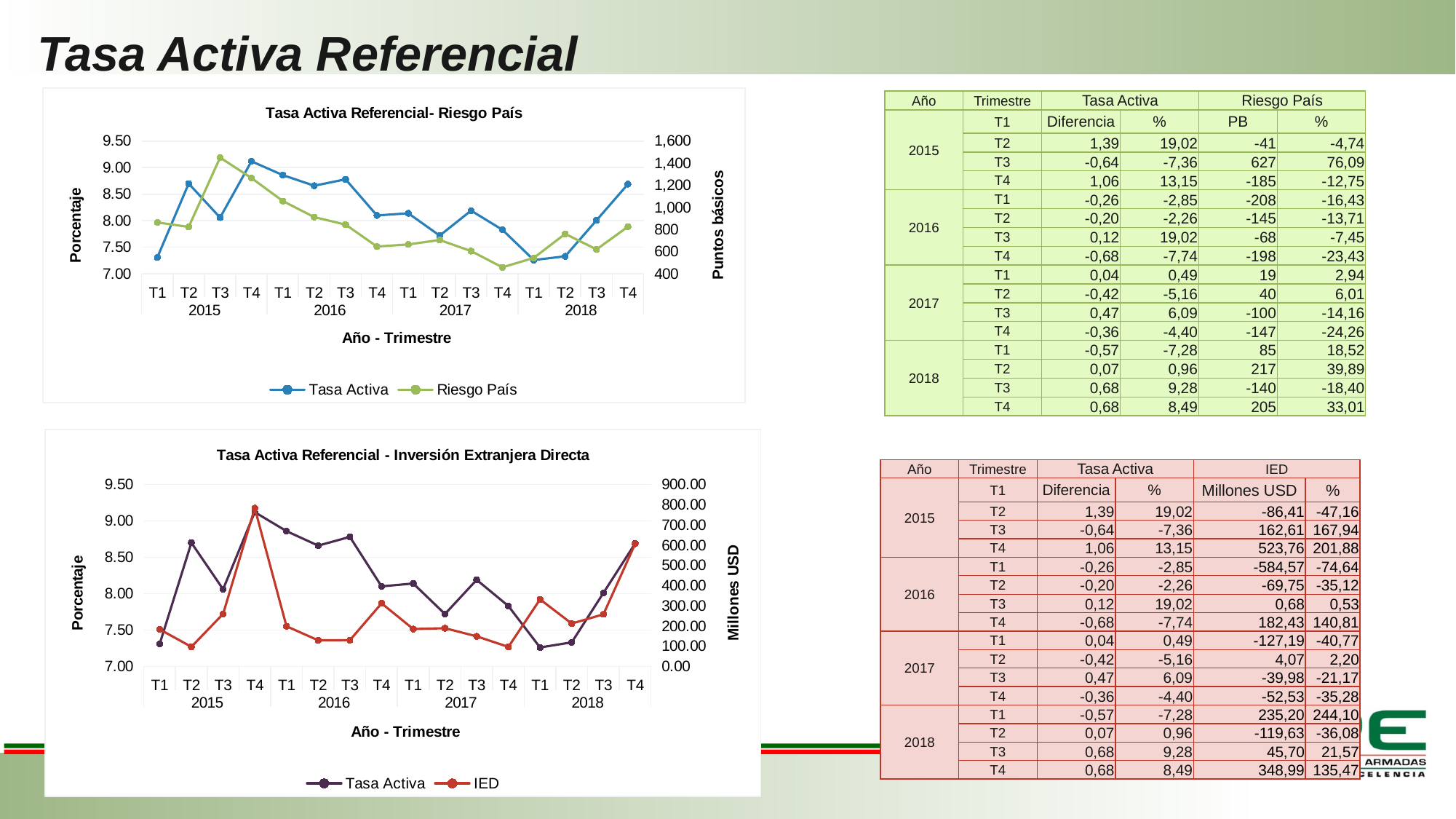
What type of chart is 'Tasa Activa Referencial- Riesgo País'? line chart In the 'Tasa Activa Referencial - Inversión Extranjera Directa' chart, is the IED value for T4 2015 greater or less than 700.00? greater In the 'Tasa Activa Referencial- Riesgo País' chart, in which quarter does Riesgo País reach its lowest value? T4 2017 How many quarterly points are plotted for each series in the 'Tasa Activa Referencial- Riesgo País' chart? 16 In the 'Tasa Activa Referencial- Riesgo País' chart, is the Riesgo País value for T3 2015 greater or less than 1,200? greater In the 'Tasa Activa Referencial - Inversión Extranjera Directa' chart, which is larger, the IED value for T4 2015 or for T1 2016? T4 2015 In the 'Tasa Activa Referencial - Inversión Extranjera Directa' chart, in which quarter does IED reach its highest value? T4 2015 In the 'Tasa Activa Referencial- Riesgo País' chart, in which quarter does Tasa Activa reach its highest value? T4 2015 How many series does the legend of the 'Tasa Activa Referencial - Inversión Extranjera Directa' chart list? 2 In the 'Tasa Activa Referencial- Riesgo País' chart, is the Tasa Activa value for T1 2015 greater or less than 7.50? less In the 'Tasa Activa Referencial - Inversión Extranjera Directa' chart, does Tasa Activa rise or fall from T1 2018 to T4 2018? rise In the 'Tasa Activa Referencial- Riesgo País' chart, in which quarter does Riesgo País reach its highest value? T3 2015